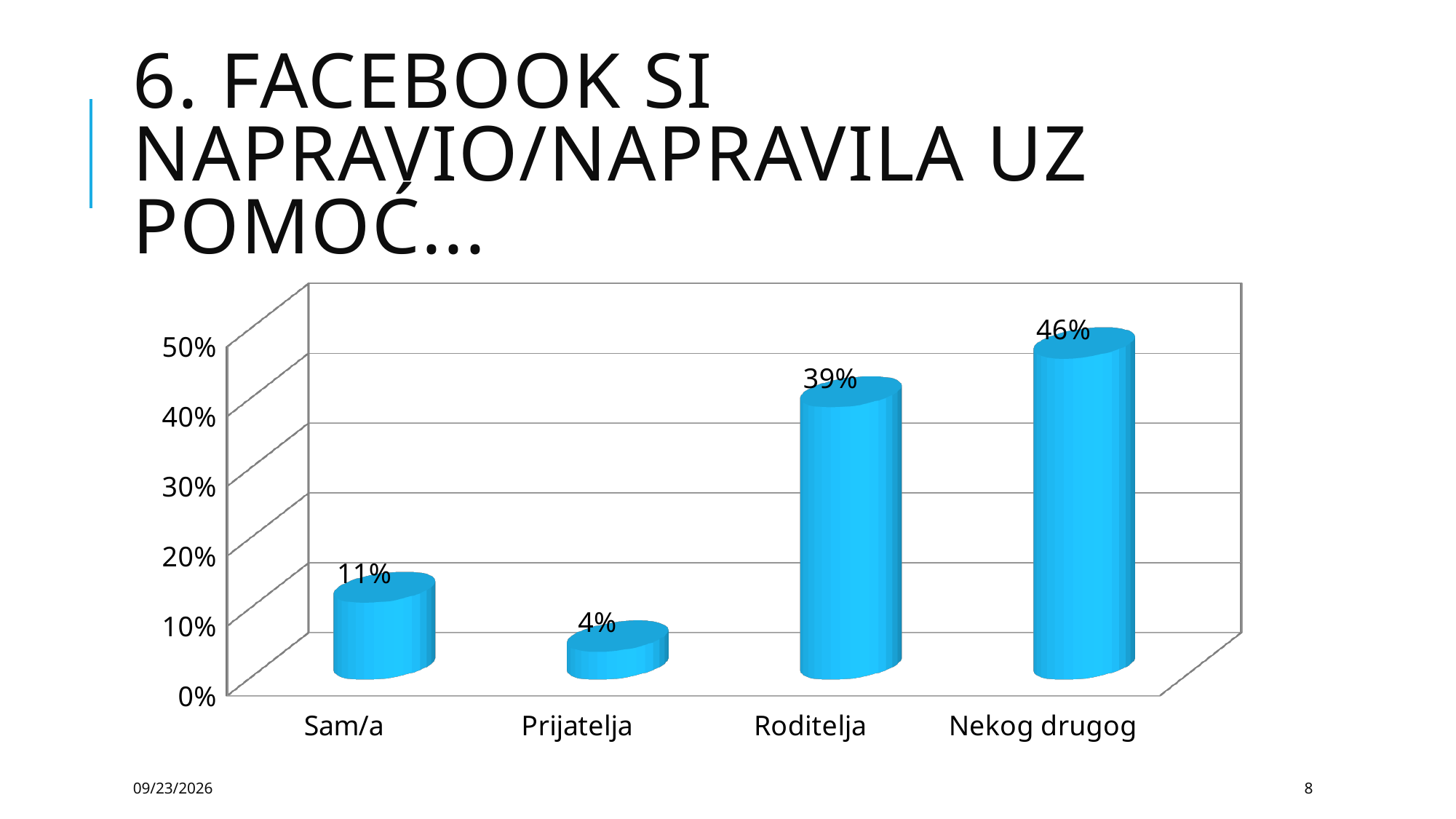
How many categories are shown on the x axis? 4 Which category has the highest value? Nekog drugog What is the title of the slide containing the chart? 6. FACEBOOK SI NAPRAVIO/NAPRAVILA UZ POMOĆ... What is the difference between the values for Sam/a and Prijatelja? 7% What is the value for Prijatelja? 4% Which category has the lowest value? Prijatelja What is the difference between the values for Nekog drugog and Roditelja? 7% What is the value for Sam/a? 11% Which is larger, the value for Roditelja or the value for Sam/a? Roditelja What is the value for Nekog drugog? 46% What is the value for Roditelja? 39% What kind of chart is shown on the slide? bar chart